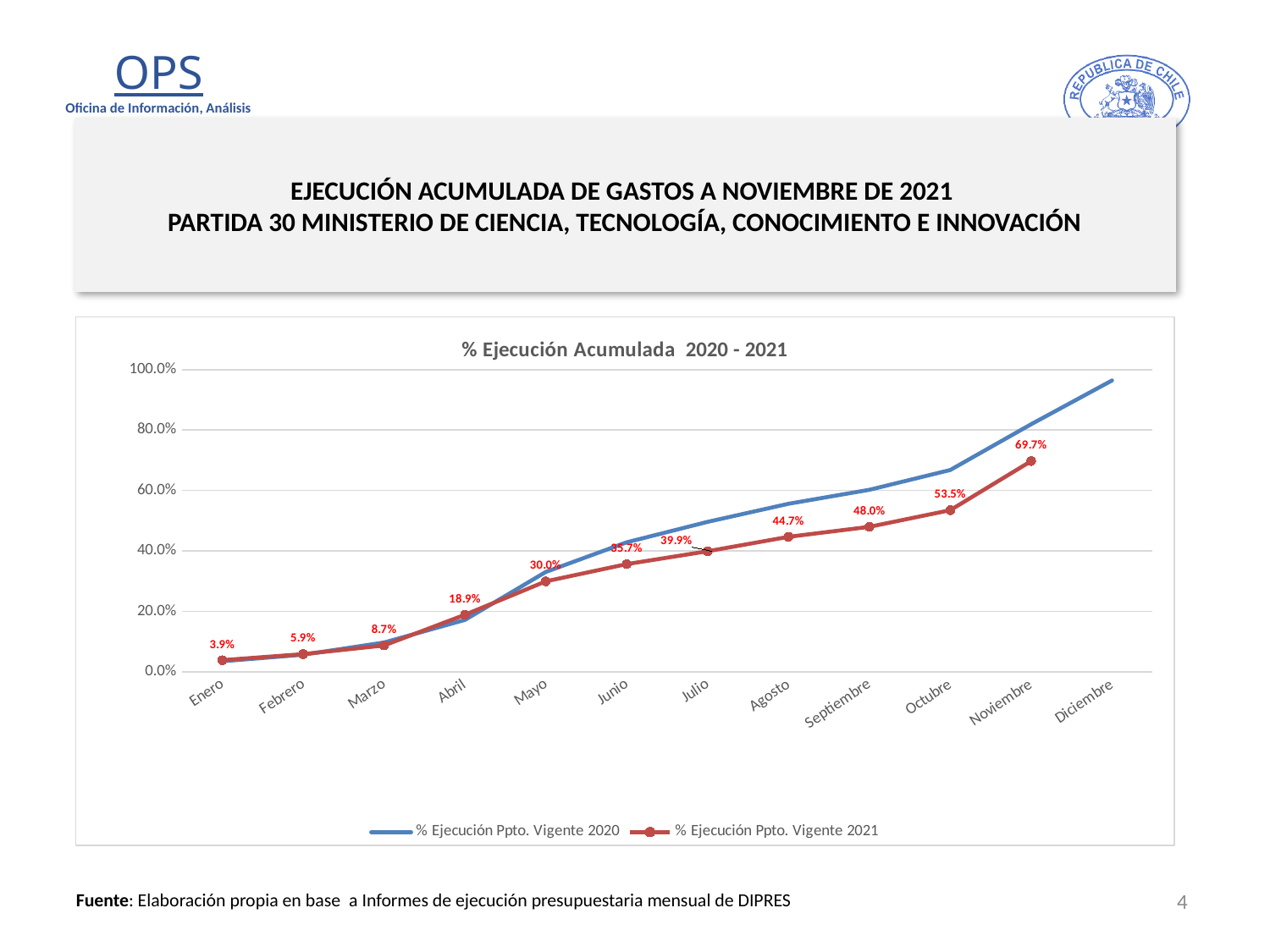
Is the value of % Ejecución Ppto. Vigente 2020 for Agosto greater or less than 60.0%? less What is the value of % Ejecución Ppto. Vigente 2021 for Septiembre? 48.0% What is the difference between the % Ejecución Ppto. Vigente 2021 values for Noviembre and Octubre? 16.2% Is the value of % Ejecución Ppto. Vigente 2020 for Diciembre greater or less than 80.0%? greater How many series does the legend list? 2 What is the value of % Ejecución Ppto. Vigente 2021 for Noviembre? 69.7% What is the value of % Ejecución Ppto. Vigente 2021 for Enero? 3.9% For Noviembre, which series has the larger value, % Ejecución Ppto. Vigente 2020 or % Ejecución Ppto. Vigente 2021? % Ejecución Ppto. Vigente 2020 What kind of chart is shown on the slide? Line chart Which month has the lowest labelled value for % Ejecución Ppto. Vigente 2021? Enero What is the value of % Ejecución Ppto. Vigente 2021 for Mayo? 30.0% Which month has the highest labelled value for % Ejecución Ppto. Vigente 2021? Noviembre